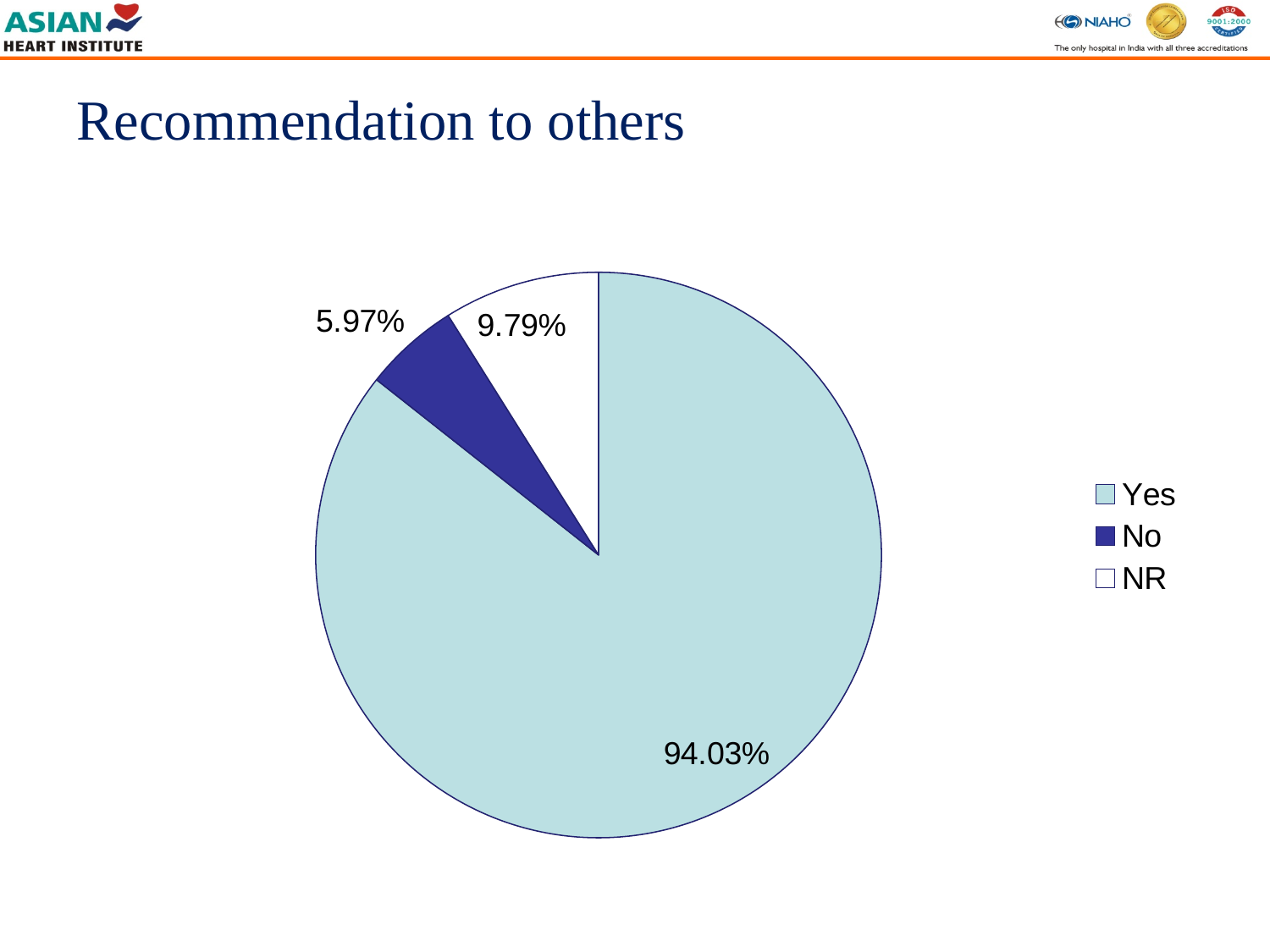
What kind of chart is shown on the slide? Pie chart What percentage of the pie is labelled for the Yes slice? 94.03% What is the difference between the NR percentage and the No percentage? 3.82% Which category has the largest slice of the pie? Yes What is the difference between the Yes percentage and the No percentage? 88.06% Which slice is larger, No or NR? NR What percentage is shown for the No slice? 5.97% How many categories does the legend list? 3 What is the title of the slide containing the chart? Recommendation to others What colour is the No slice in the pie chart? Dark blue Which category has the smallest slice of the pie? No What percentage is shown for the NR slice? 9.79%